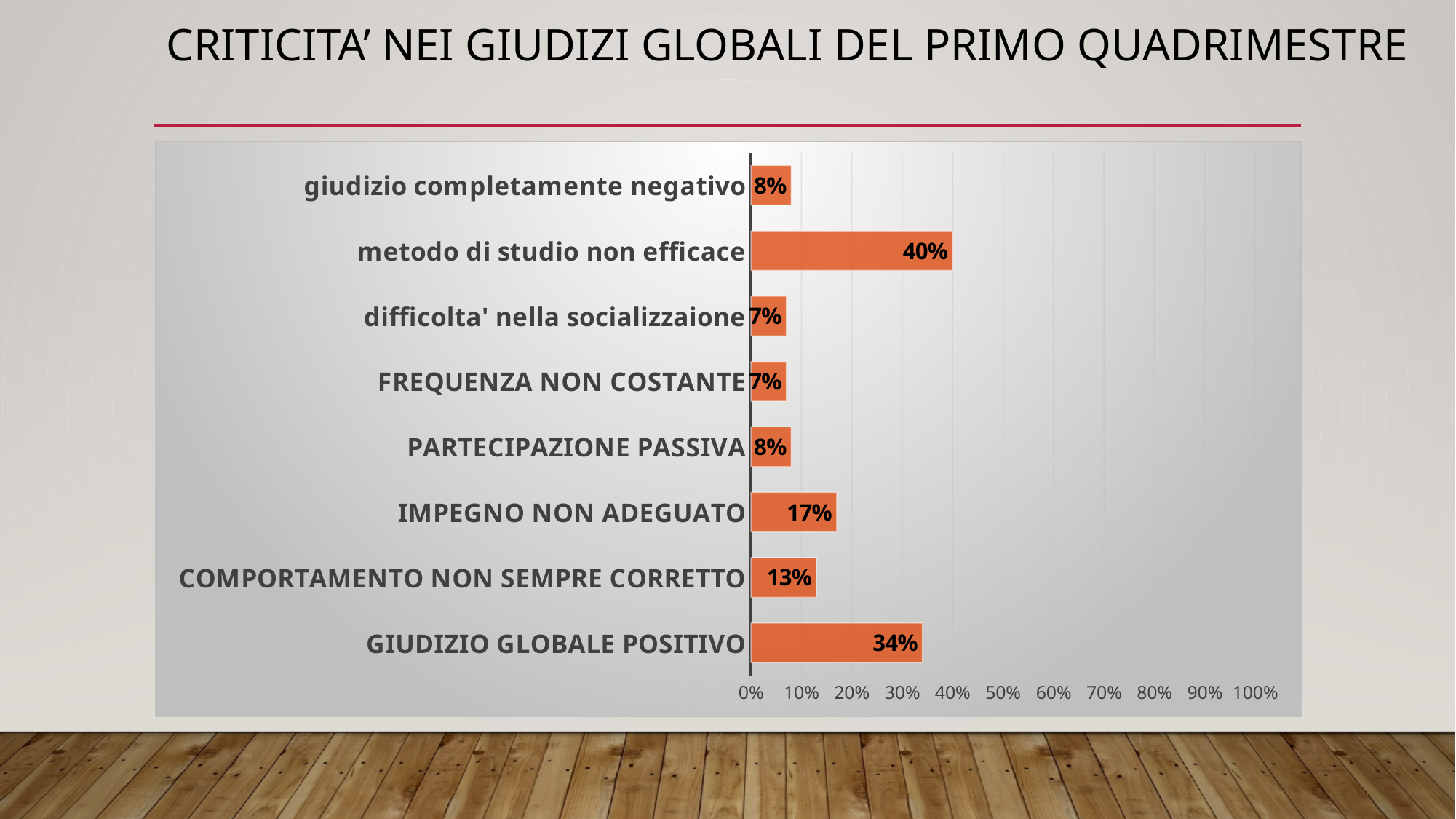
What is the difference between 'metodo di studio non efficace' and 'GIUDIZIO GLOBALE POSITIVO'? 6% What is the difference between 'IMPEGNO NON ADEGUATO' and 'COMPORTAMENTO NON SEMPRE CORRETTO'? 4% How many categories are shown in the chart? 8 What is the value for 'COMPORTAMENTO NON SEMPRE CORRETTO'? 13% Which is larger, 'IMPEGNO NON ADEGUATO' or 'PARTECIPAZIONE PASSIVA'? IMPEGNO NON ADEGUATO What is the value for 'GIUDIZIO GLOBALE POSITIVO'? 34% Which category has the highest value? metodo di studio non efficace What is the value for 'metodo di studio non efficace'? 40% What kind of chart is shown on the slide? Bar chart Is the value for 'metodo di studio non efficace' greater or less than 30%? greater What is the value for 'IMPEGNO NON ADEGUATO'? 17% What is the title of the slide? CRITICITA' NEI GIUDIZI GLOBALI DEL PRIMO QUADRIMESTRE